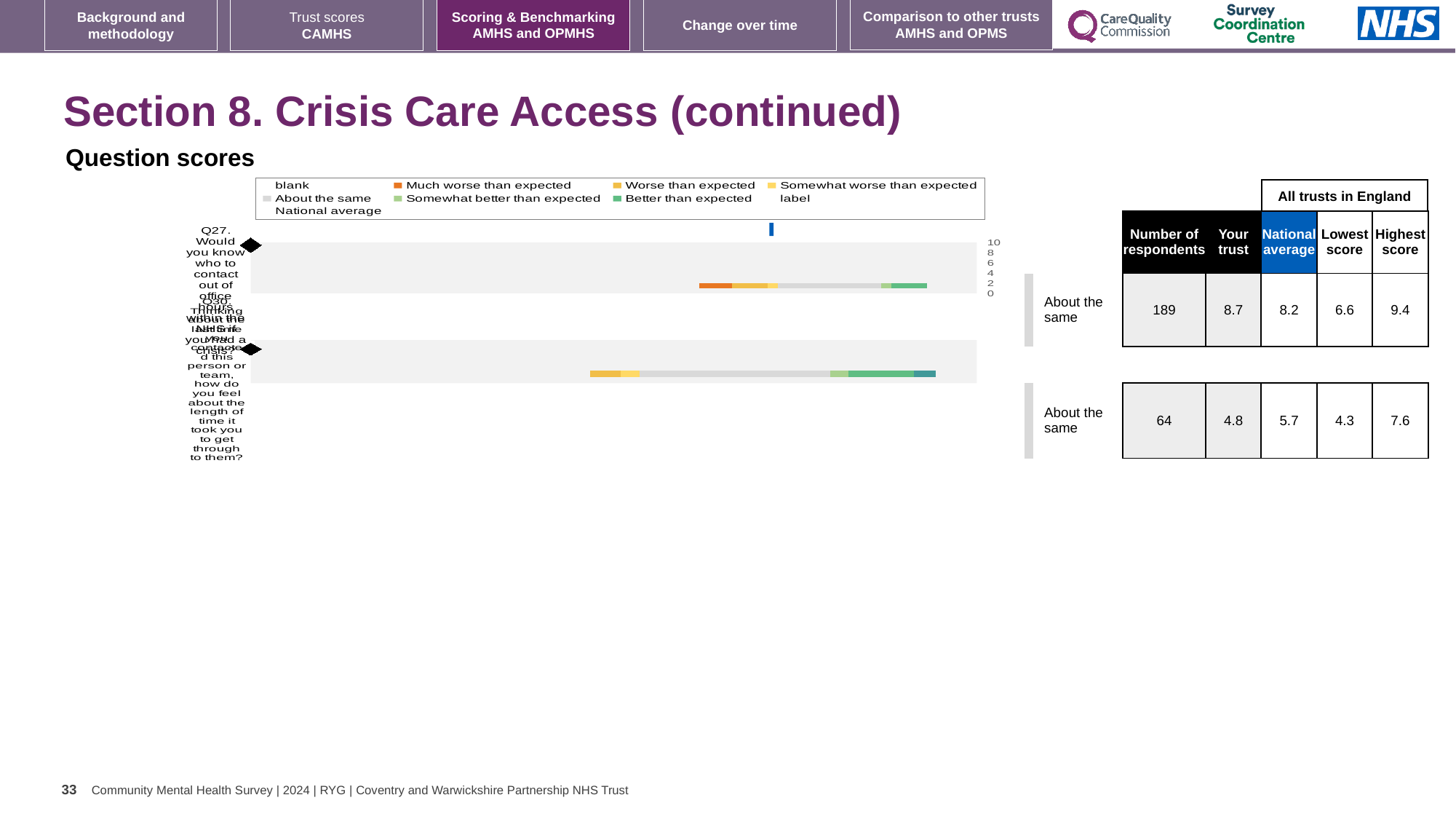
How many entries does the legend of the Question scores chart list? 9 What is the difference between the national average and the trust's score for Q30? 0.9 What benchmark category is the trust's Q30 score placed in? About the same What colour represents "Much worse than expected" in the chart legend? orange What kind of chart is shown under "Question scores"? bar chart What is the national average score for Q30 (length of time it took to get through)? 5.7 For Q27, which is higher: the trust's score or the national average? the trust's score How many respondents answered Q27? 189 What is the highest score among all trusts in England for Q27? 9.4 How many questions (bars) are plotted in the Question scores chart? 2 What is the lowest score among all trusts in England for Q30? 4.3 What is the "Your trust" score for Q27 (knowing who to contact out of office hours)? 8.7